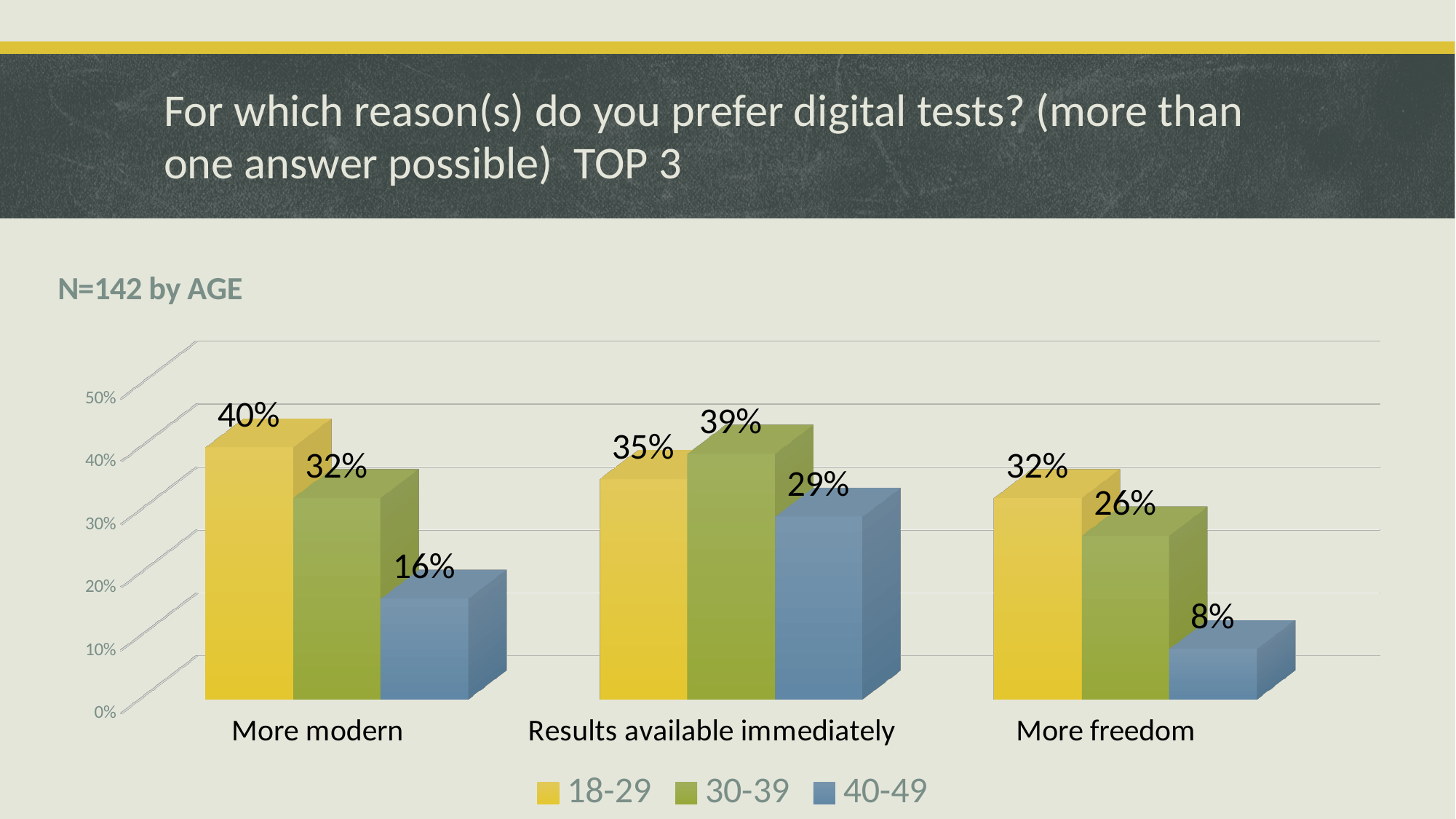
Which age group has the highest value for 'Results available immediately'? 30-39 What percentage of the 30-39 age group chose 'More freedom'? 26% What is the difference between the 18-29 and 40-49 values for 'More modern'? 24 percentage points What is the sample size stated above the chart? N=142 What percentage of the 18-29 age group chose 'More modern'? 40% Which age group has the lowest value for 'More freedom'? 40-49 Which is larger: the 18-29 value for 'More modern' or the 18-29 value for 'Results available immediately'? More modern How many reason categories are shown on the x axis? 3 Is the 40-49 value for 'More freedom' greater or less than 10%? less What kind of chart is shown on the slide? Bar chart What is the value for the 40-49 age group for 'Results available immediately'? 29% How many age groups does the legend list? 3